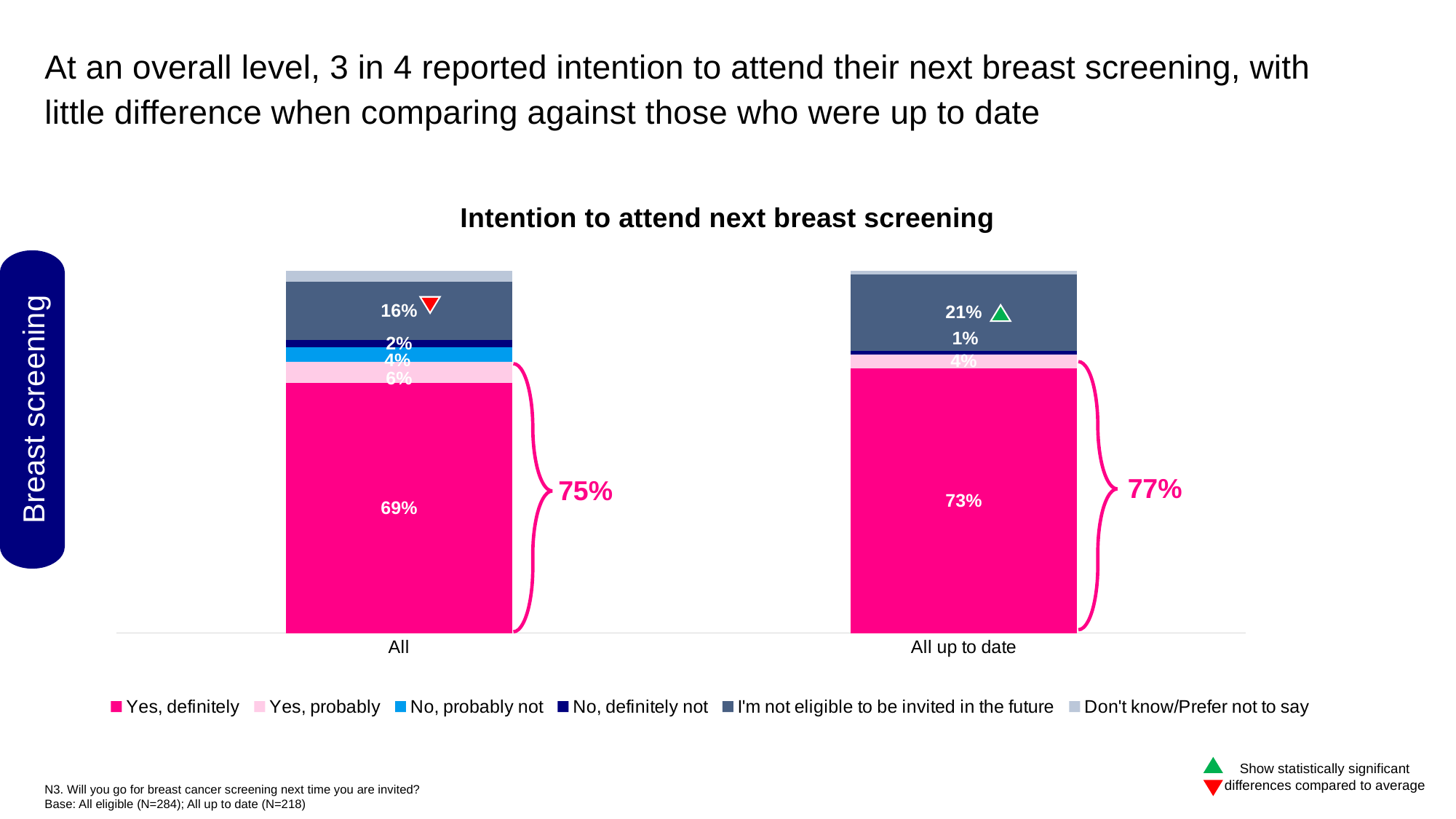
What percentage of the 'All' group answered 'Yes, probably'? 6% What percentage of the 'All up to date' group answered 'Yes, definitely'? 73% What percentage of the 'All up to date' group said they are not eligible to be invited in the future? 21% What combined 'Yes' percentage is shown by the bracket next to the 'All' bar? 75% What is the title of the chart? Intention to attend next breast screening What is the difference in the 'Yes, definitely' share between 'All up to date' and 'All'? 4 percentage points How many series does the legend list? 6 What percentage of the 'All' group said they are not eligible to be invited in the future? 16% What kind of chart is shown on the slide? Stacked bar chart How many categories (bars) are shown on the x axis? 2 What percentage of the 'All' group answered 'Yes, definitely'? 69% Which group has the higher 'Yes, definitely' share, 'All' or 'All up to date'? All up to date